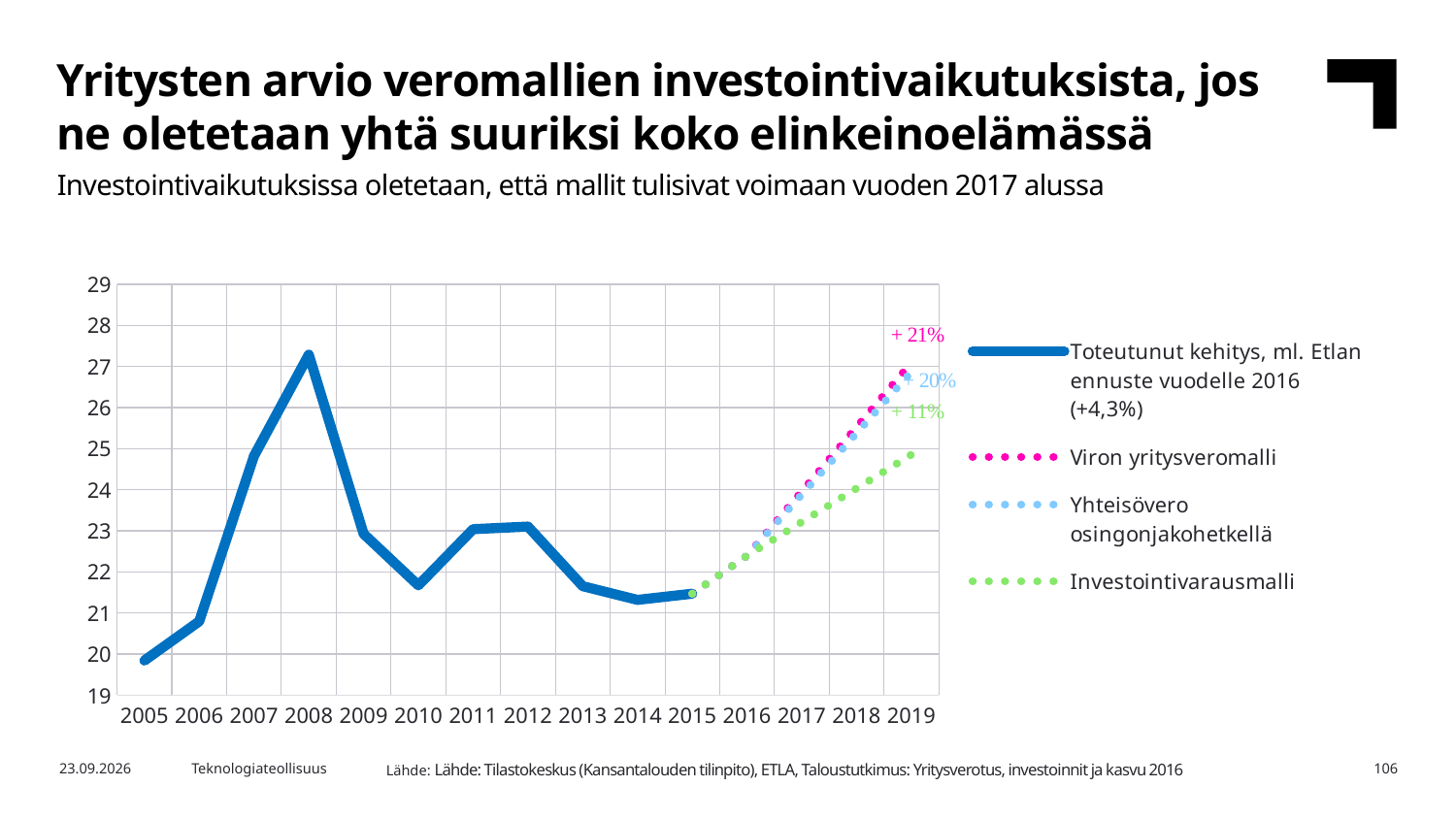
In which year does the solid blue line (Toteutunut kehitys) reach its highest value? 2008 In which year does the solid blue line (Toteutunut kehitys) have its lowest value? 2005 What percentage change is labelled for the Viron yritysveromalli series at the end of the projection? + 21% Which projected series ends lowest in 2019? Investointivarausmalli How many series does the legend list? 4 Which is larger for the solid blue line: the value in 2008 or the value in 2011? 2008 Is the value of the solid blue line in 2005 greater or less than 20? less Is the value of the solid blue line in 2008 greater or less than 26? greater What kind of chart is shown on the slide? line chart What percentage change is labelled for the Yhteisövero osingonjakohetkellä series at the end of the projection? + 20% Does the solid blue line rise or fall between 2008 and 2010? fall What percentage change is labelled for the Investointivarausmalli series at the end of the projection? + 11%